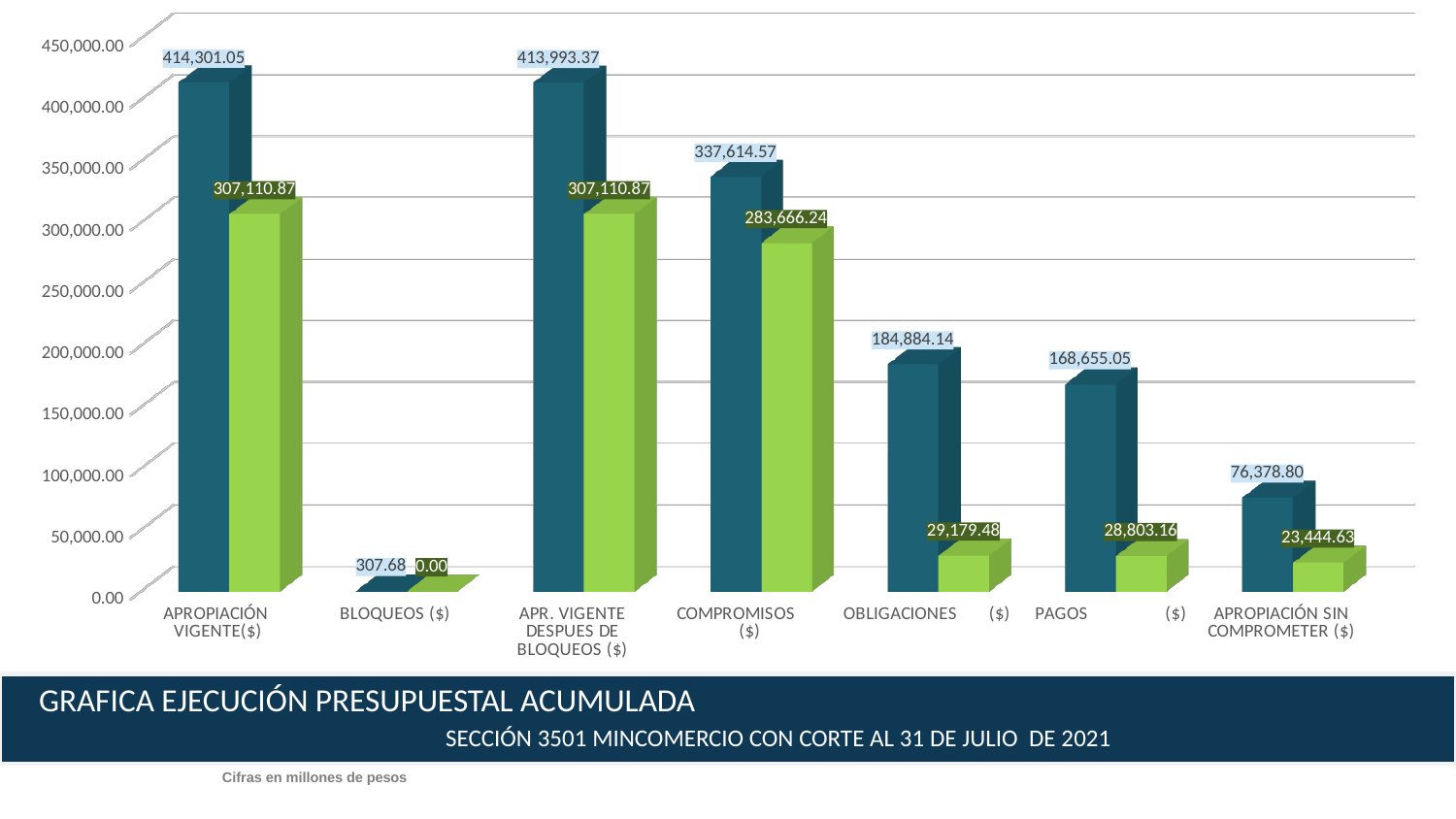
Is the dark blue value for APROPIACIÓN SIN COMPROMETER ($) greater or less than 100,000.00? less What is the value of the green bar for OBLIGACIONES ($)? 29,179.48 What is the difference between the dark blue bars for APROPIACIÓN VIGENTE($) and APR. VIGENTE DESPUES DE BLOQUEOS ($)? 307.68 What is the value of the dark blue bar for COMPROMISOS ($)? 337,614.57 What is the title of the chart? GRAFICA EJECUCIÓN PRESUPUESTAL ACUMULADA What kind of chart is shown on the slide? bar chart Which category has the highest dark blue bar? APROPIACIÓN VIGENTE($) What is the difference between the dark blue bar and the green bar for PAGOS ($)? 139,851.89 Which category has the lowest green bar? BLOQUEOS ($) How many categories are shown on the x axis? 7 What is the value of the green bar for APR. VIGENTE DESPUES DE BLOQUEOS ($)? 307,110.87 Which has the larger dark blue bar, OBLIGACIONES ($) or PAGOS ($)? OBLIGACIONES ($)